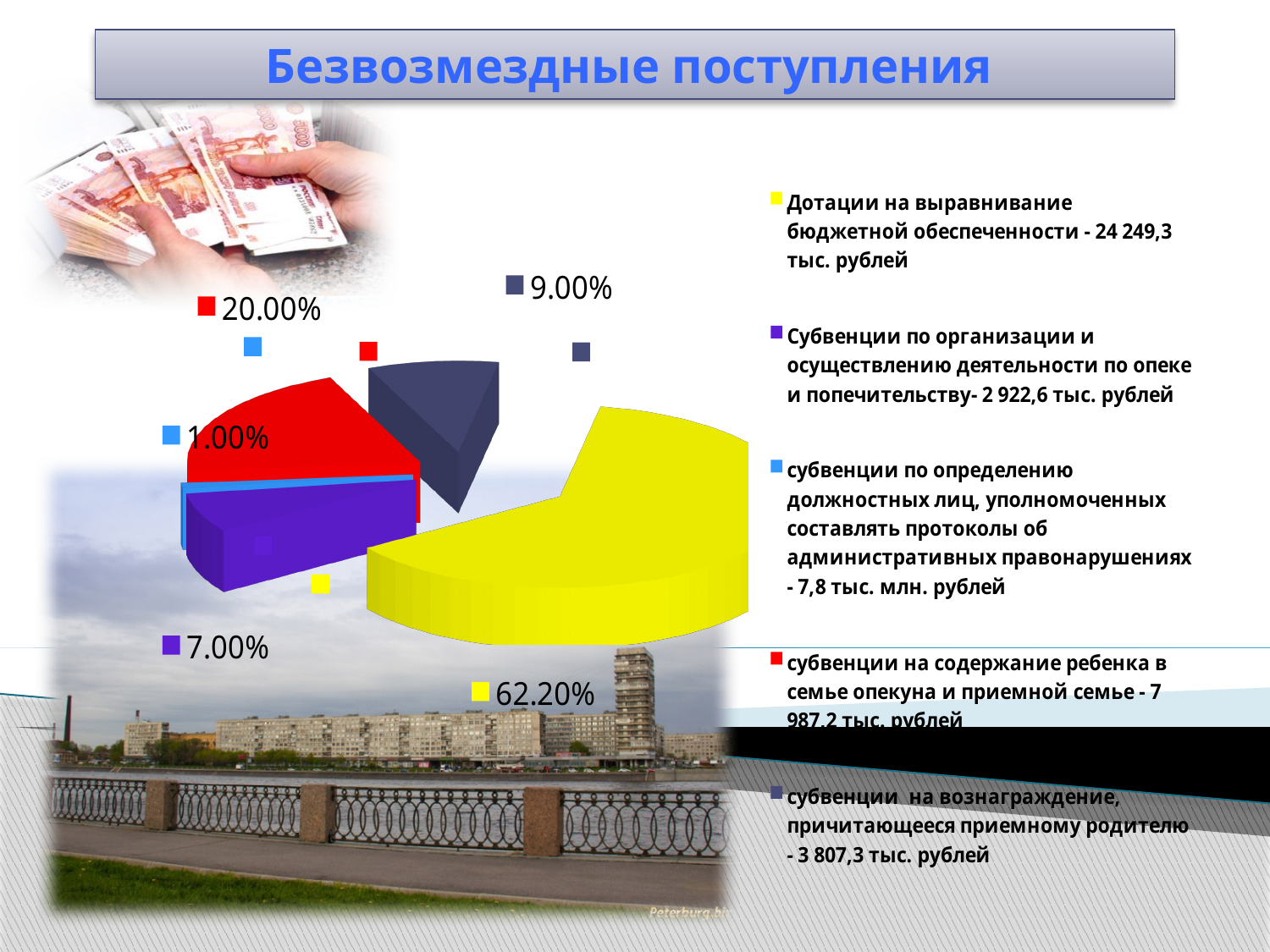
Which slice of the pie chart is the largest? Дотации на выравнивание бюджетной обеспеченности (62.20%) What share does the light blue slice (субвенции по определению должностных лиц) have? 1.00% What is the title of the slide containing the chart? Безвозмездные поступления What is the difference in percentage points between the red slice (20.00%) and the dark blue slice (9.00%)? 11.00% How many slices does the pie chart have? 5 Which slice of the pie chart is the smallest? субвенции по определению должностных лиц (1.00%) What kind of chart is shown on the slide? Pie chart Which is larger: the purple slice or the dark blue slice? The dark blue slice (9.00%) What share does the yellow slice (Дотации на выравнивание бюджетной обеспеченности) have? 62.20% What share does the red slice (субвенции на содержание ребенка в семье опекуна и приемной семье) have? 20.00%